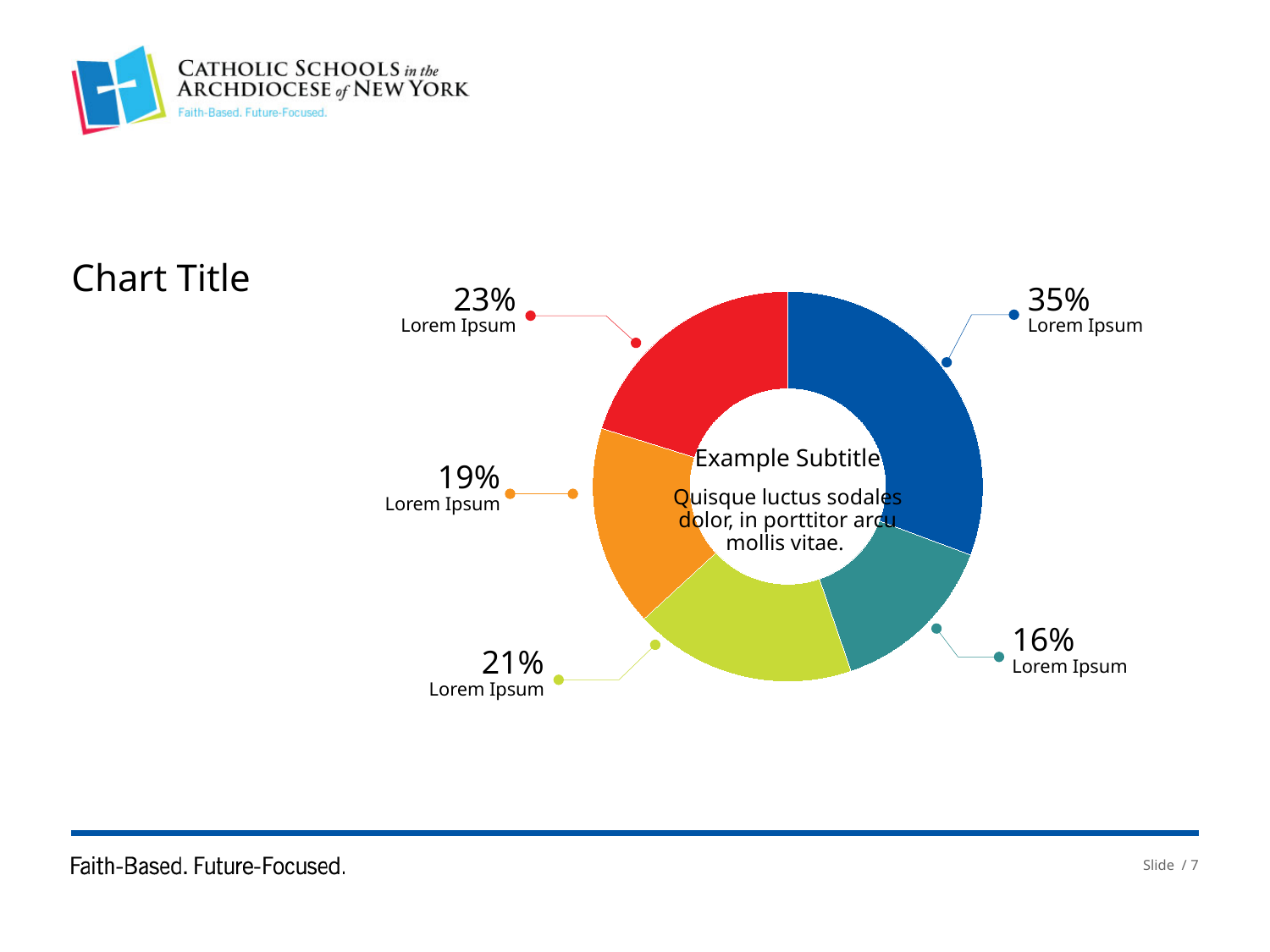
What kind of chart is shown on the slide? Pie chart (donut) Which is larger, the red slice's percentage or the lime green slice's percentage? The red slice (23%) Which slice of the donut chart has the smallest percentage? The teal slice, 16% What percentage is labelled on the lime green slice of the donut chart? 21% What is the difference between the red slice's percentage and the orange slice's percentage? 4% What percentage is labelled on the red slice of the donut chart? 23% Which slice of the donut chart has the largest percentage? The blue slice, 35% How many slices does the donut chart have? 5 What is the title of the chart on the slide? Chart Title What is the difference between the blue slice's percentage and the teal slice's percentage? 19% What percentage is labelled on the orange slice of the donut chart? 19% What subtitle text appears in the centre of the donut chart? Example Subtitle